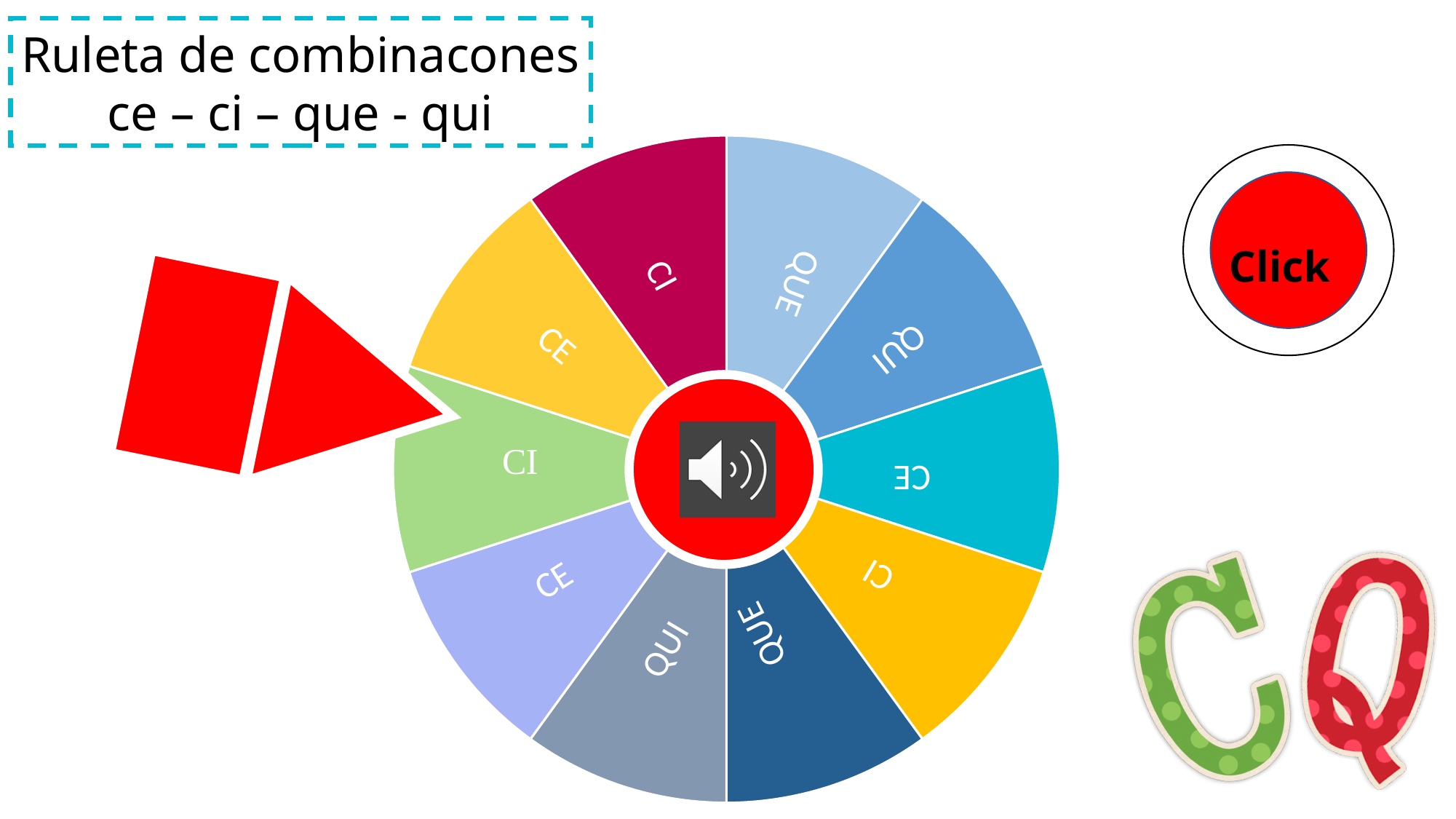
How many segments of the wheel are labelled QUE? 2 Which segment label is the red arrow pointing at on the wheel? CI How many segments does the roulette wheel on the slide have? 10 How many different syllable labels appear on the wheel? 4 What kind of chart is the wheel on the slide drawn as? pie chart What is the title shown in the dashed box at the top left of the slide? Ruleta de combinacones ce – ci – que - qui Which syllables are listed in the title box of the slide? ce – ci – que - qui